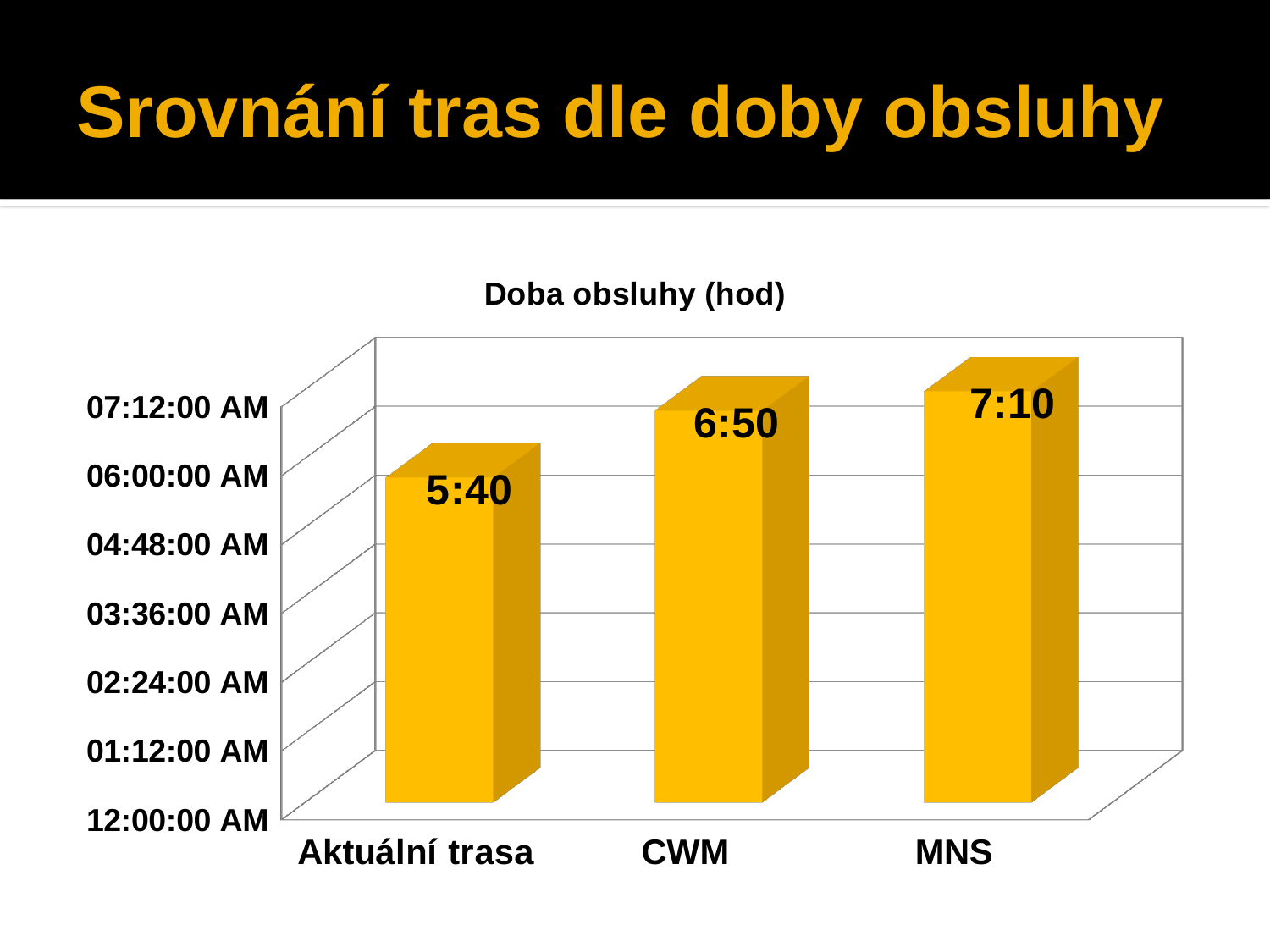
Which category has the lowest value in the chart? Aktuální trasa What is the title of the chart? Doba obsluhy (hod) What is the difference between the values for CWM and Aktuální trasa? 1:10 Which is larger, the value for CWM or the value for Aktuální trasa? CWM How many categories are shown in the chart? 3 What is the difference between the values for MNS and CWM? 0:20 What is the value for Aktuální trasa in the chart? 5:40 What is the value for CWM in the chart? 6:50 What is the value for MNS in the chart? 7:10 Which category has the highest value in the chart? MNS Is the value for Aktuální trasa greater or less than 06:00:00 AM on the axis? less What kind of chart is shown on the slide? bar chart